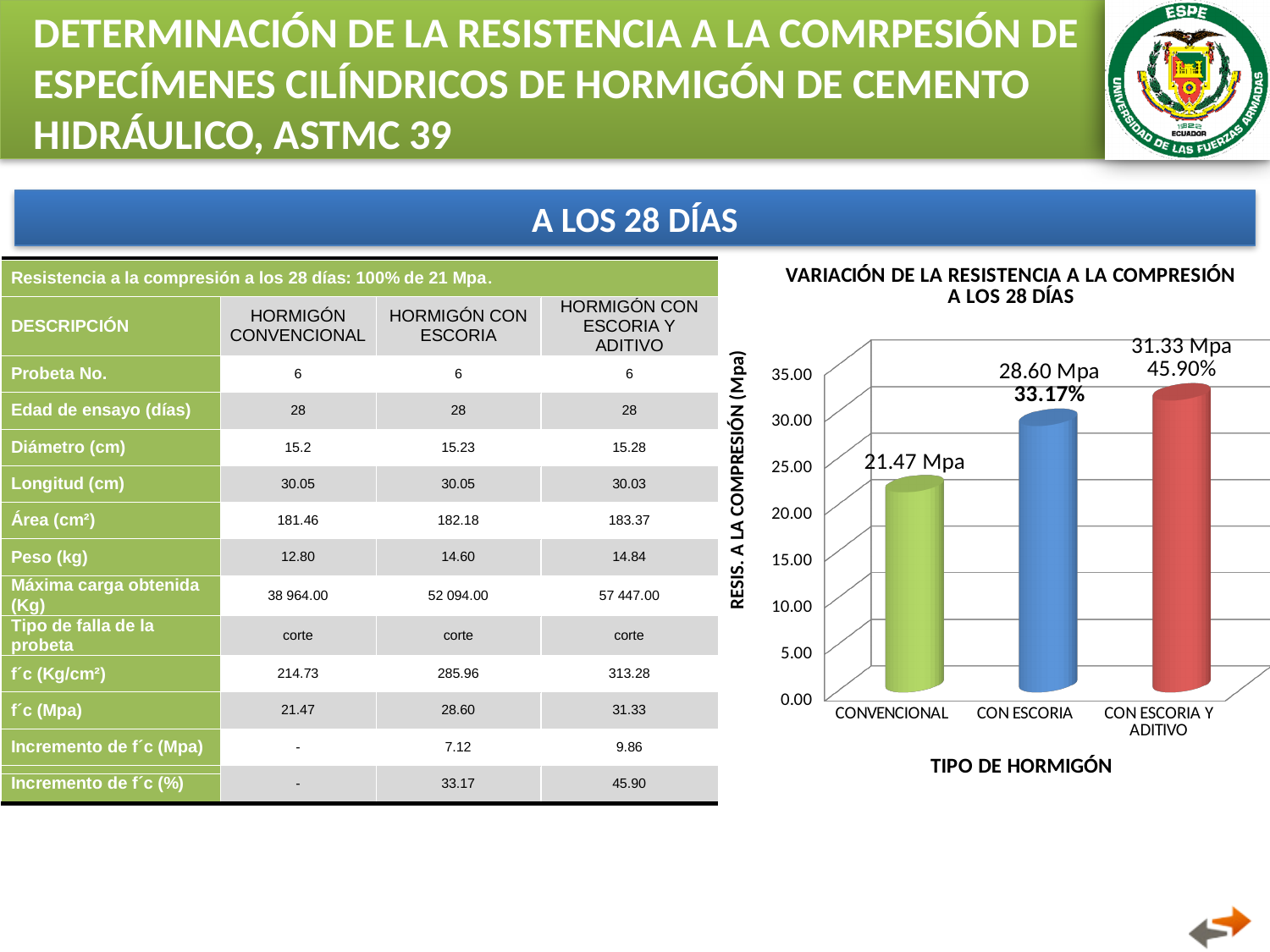
What is the difference in compressive strength between CON ESCORIA Y ADITIVO and CONVENCIONAL? 9.86 Mpa What is the title of the chart's x axis? TIPO DE HORMIGÓN What is the compressive strength value shown for CON ESCORIA in the chart? 28.60 Mpa What is the compressive strength value shown for CON ESCORIA Y ADITIVO in the chart? 31.33 Mpa What is the compressive strength value shown for CONVENCIONAL in the chart? 21.47 Mpa Which type of concrete has the highest compressive strength in the chart? CON ESCORIA Y ADITIVO Which has a larger compressive strength, CON ESCORIA or CONVENCIONAL? CON ESCORIA How many types of concrete are plotted in the chart? 3 What type of chart is shown on the slide? bar chart Which type of concrete has the lowest compressive strength in the chart? CONVENCIONAL What percentage increase is labelled above the CON ESCORIA bar? 33.17% What percentage increase is labelled above the CON ESCORIA Y ADITIVO bar? 45.90%